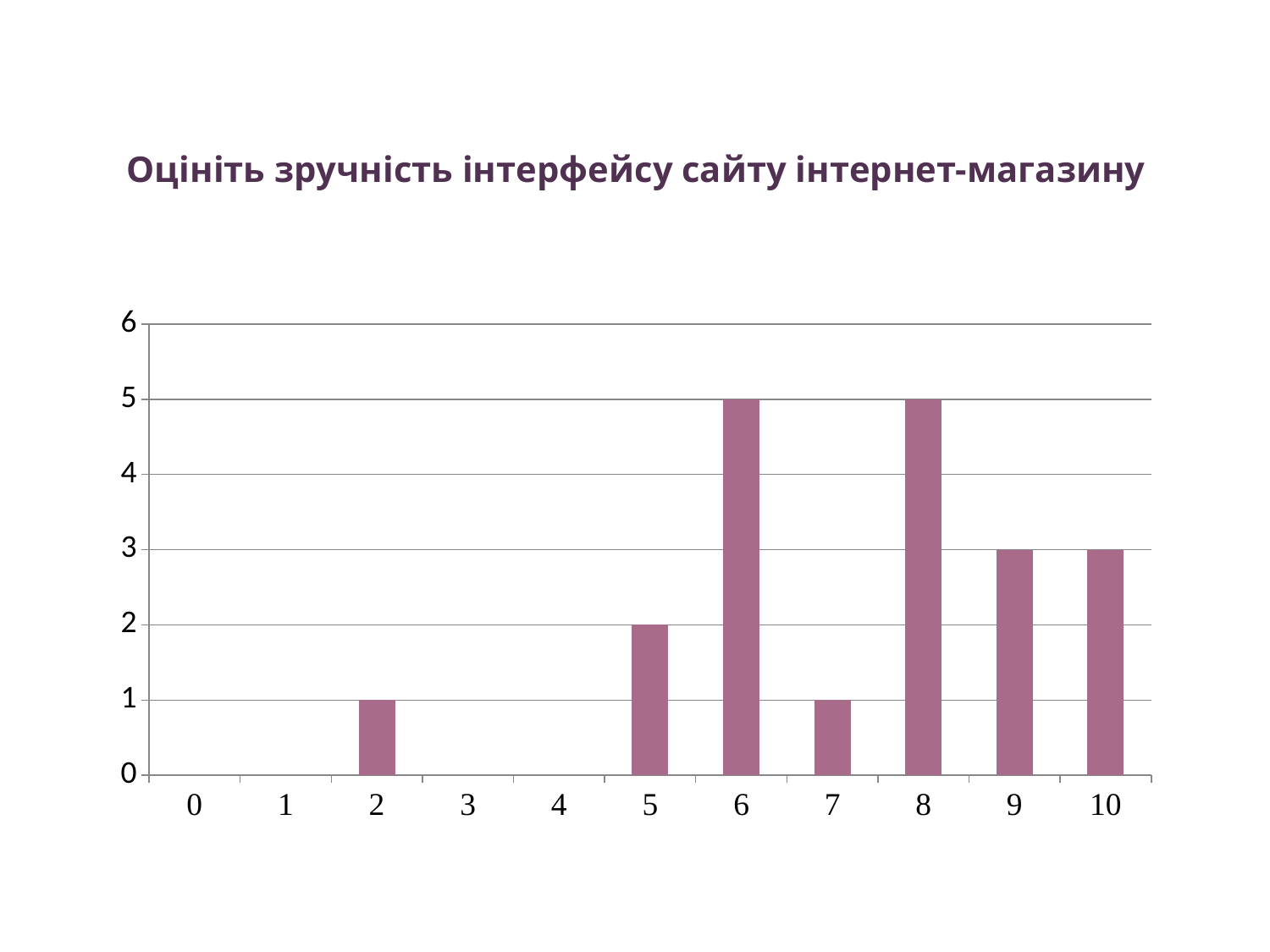
Is the value for category 6 greater or less than 4? greater What is the title of the chart? Оцініть зручність інтерфейсу сайту інтернет-магазину How many categories are shown on the x axis? 11 What is the value for category 5? 2 Which has the larger value, category 2 or category 10? 10 What is the value for category 2? 1 What kind of chart is shown on the slide? bar chart What is the value for category 9? 3 What is the value for category 6? 5 What is the difference between the values for category 8 and category 7? 4 Which has the larger value, category 5 or category 9? 9 What is the value for category 7? 1